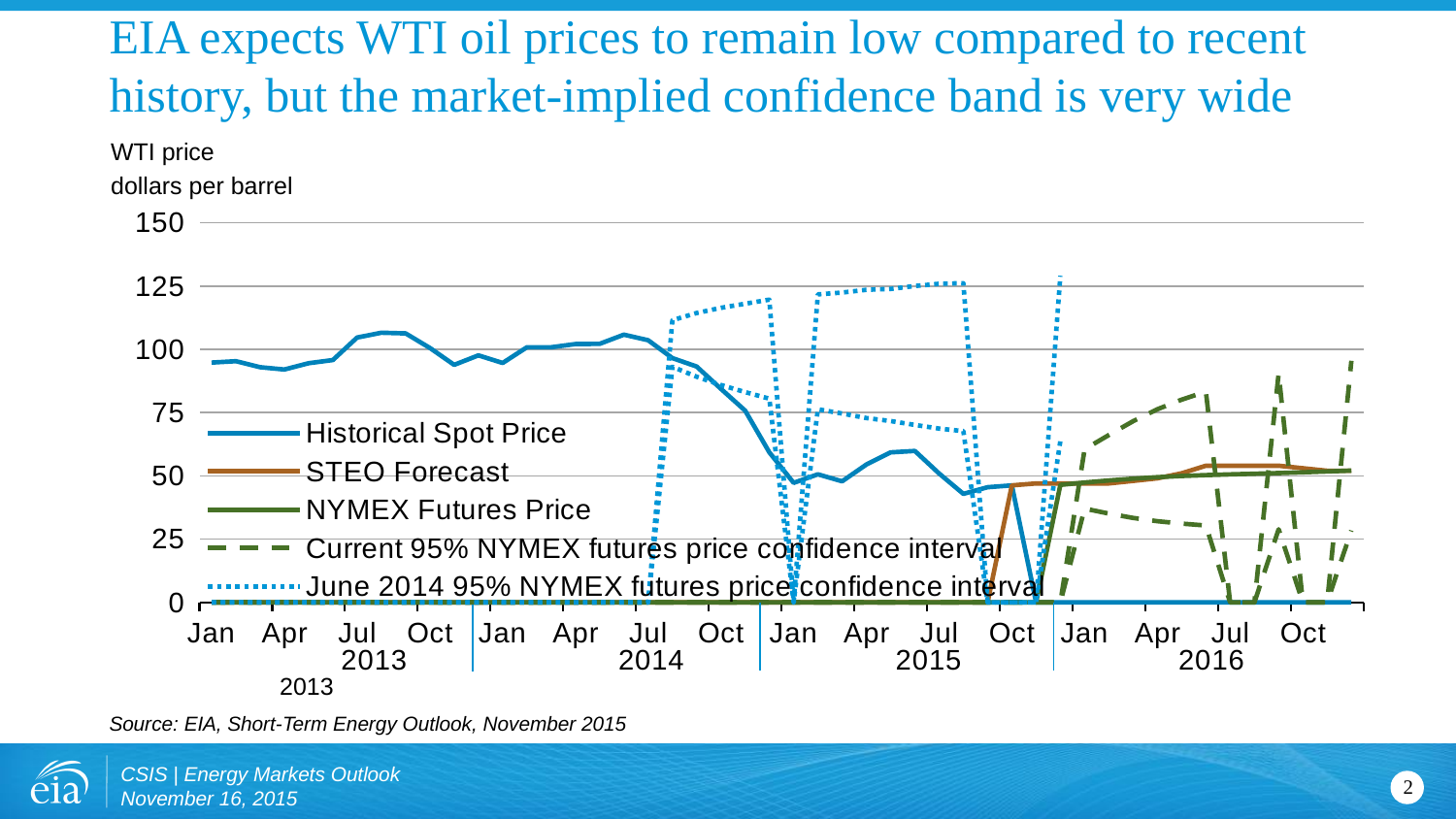
Which series is drawn with a dashed line in the legend? Current 95% NYMEX futures price confidence interval What unit is the WTI price plotted in, according to the axis label? dollars per barrel How many years are labelled along the x axis? 4 Is the Historical Spot Price in Jan 2013 greater or less than 75? greater Is the upper bound of the June 2014 95% NYMEX futures price confidence interval in Apr 2015 greater or less than 100? greater Which is larger, the Historical Spot Price in Jan 2013 or in Jan 2015? Jan 2013 Is the STEO Forecast in Jul 2016 greater or less than 75? less What kind of chart is shown on the slide? line chart How many series does the legend list? 5 Does the Historical Spot Price rise or fall between Jul 2014 and Jan 2015? fall